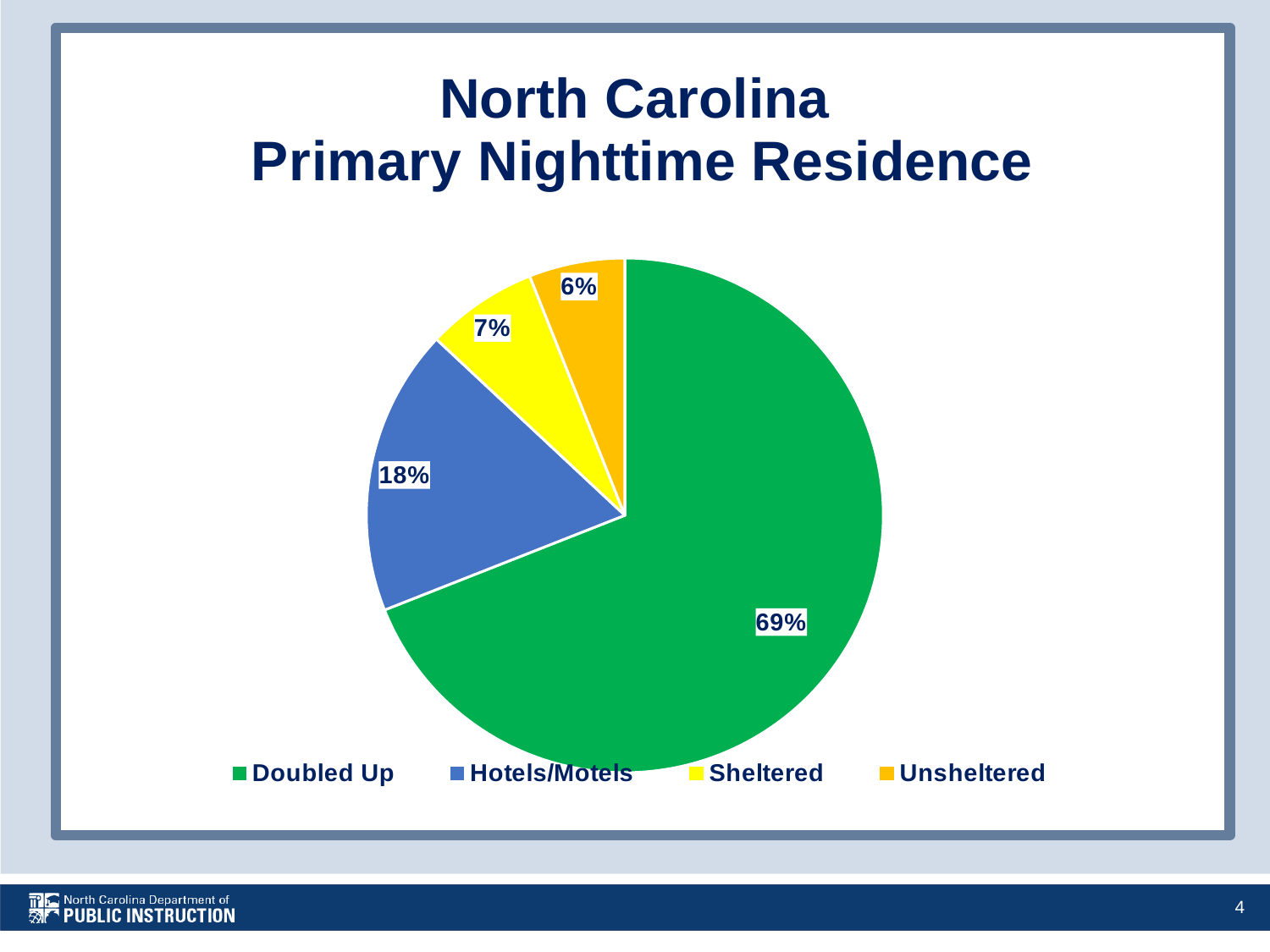
Which is larger, Sheltered or Hotels/Motels? Hotels/Motels What is the value for Unsheltered? 6% Which category has the smallest slice? Unsheltered What is the difference between the Hotels/Motels and Sheltered shares? 11% Which category has the largest slice? Doubled Up What share of the pie does Doubled Up represent? 69% What is the value for Sheltered? 7% What kind of chart is shown on the slide? Pie chart What is the value for Hotels/Motels? 18% How many categories are shown in the pie chart? 4 What colour is the Sheltered slice? Yellow What is the difference between the Doubled Up and Hotels/Motels shares? 51%